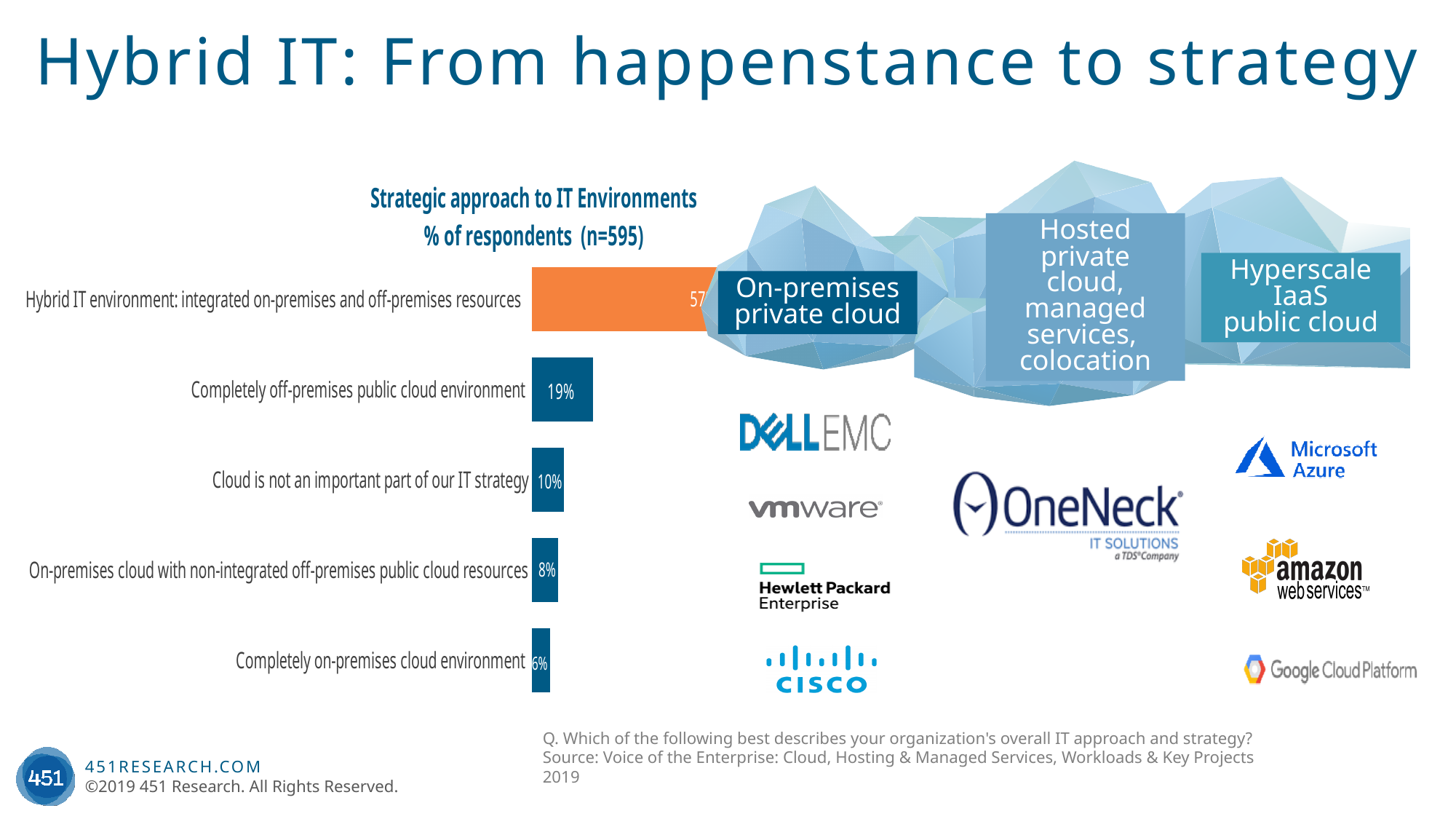
Which is larger: 'On-premises cloud with non-integrated off-premises public cloud resources' or 'Completely on-premises cloud environment'? On-premises cloud with non-integrated off-premises public cloud resources What is the value for 'Completely on-premises cloud environment'? 6% Which category has the highest share of respondents? Hybrid IT environment: integrated on-premises and off-premises resources What colour is the bar for the Hybrid IT environment category? orange What percentage of respondents chose 'Completely off-premises public cloud environment'? 19% What percentage of respondents said 'Cloud is not an important part of our IT strategy'? 10% How many categories does the chart show? 5 What is the title of the chart? Strategic approach to IT Environments % of respondents (n=595) What is the difference between 'Completely off-premises public cloud environment' and 'Cloud is not an important part of our IT strategy'? 9% What is the value for 'On-premises cloud with non-integrated off-premises public cloud resources'? 8% Which category has the lowest share of respondents? Completely on-premises cloud environment What type of chart is shown on the slide? bar chart